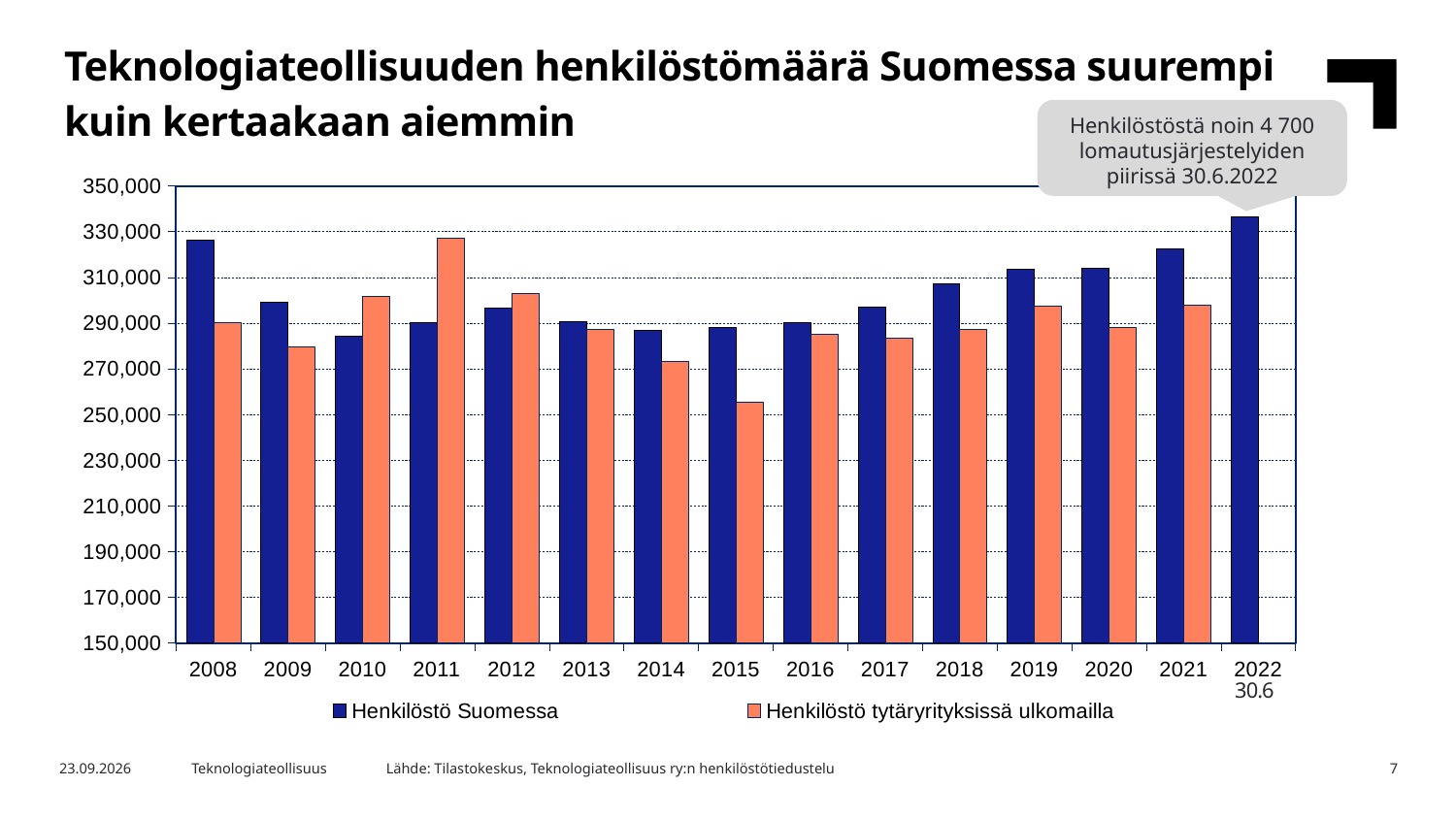
In 2011, which is larger: Henkilöstö Suomessa or Henkilöstö tytäryrityksissä ulkomailla? Henkilöstö tytäryrityksissä ulkomailla In which year is the value for Henkilöstö Suomessa highest? 2022 What kind of chart is shown on the slide? Bar chart Which series is shown in dark blue in the legend? Henkilöstö Suomessa In which year is the value for Henkilöstö tytäryrityksissä ulkomailla lowest? 2015 Is the value for Henkilöstö tytäryrityksissä ulkomailla in 2015 greater or less than 270,000? less Does the value for Henkilöstö Suomessa rise or fall from 2015 to 2022? Rise In which year is the value for Henkilöstö tytäryrityksissä ulkomailla highest? 2011 How many series does the legend list? 2 Is the value for Henkilöstö Suomessa in 2008 greater or less than 310,000? greater Is the value for Henkilöstö Suomessa in 2022 greater or less than 330,000? greater How many years are shown on the x axis of the chart? 15